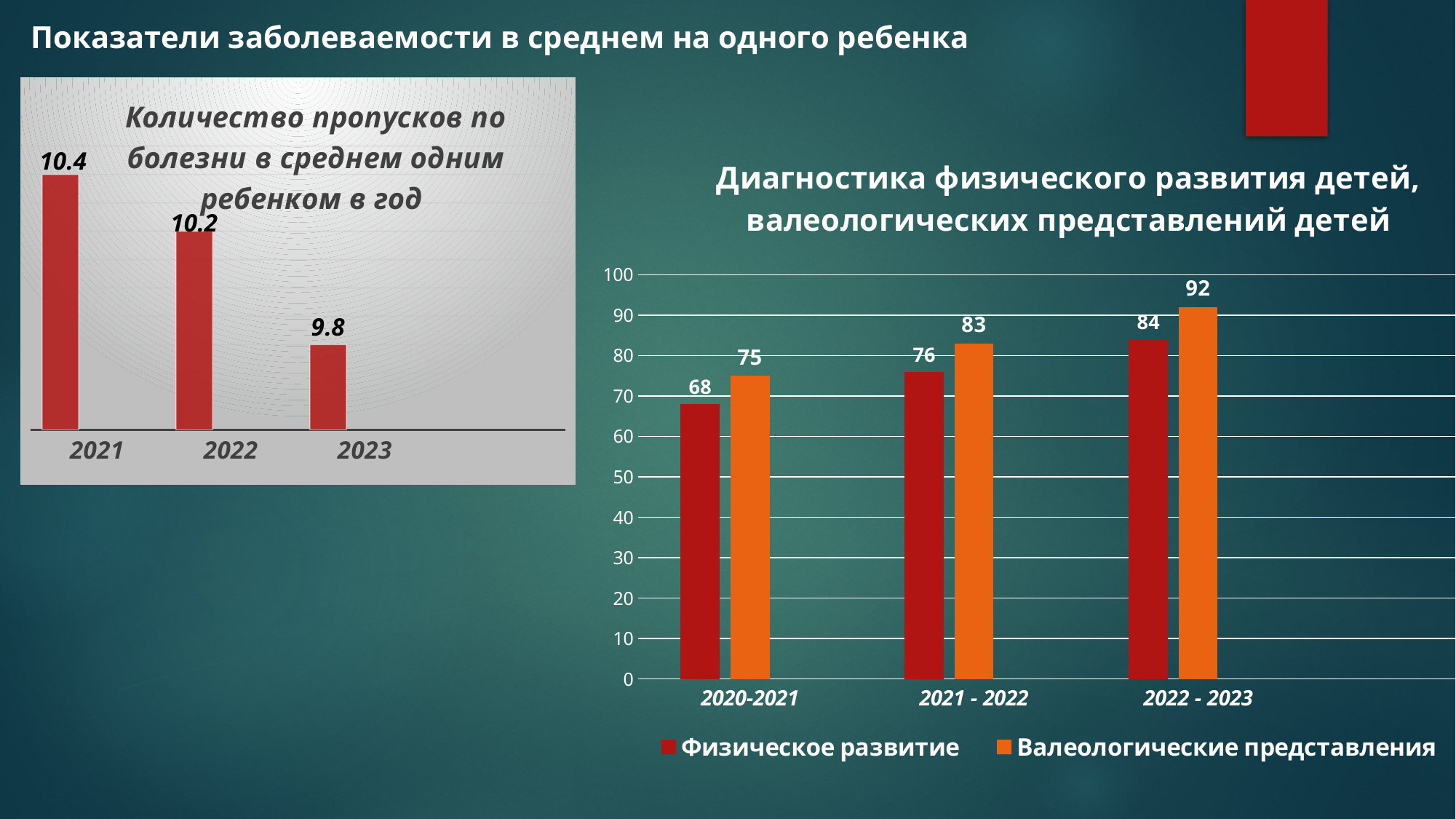
In the right chart 'Диагностика физического развития детей, валеологических представлений детей', what is the difference between Валеологические представления and Физическое развитие in 2022 - 2023? 8 In the left chart 'Количество пропусков по болезни в среднем одним ребенком в год', what is the difference between the 2021 and 2023 values? 0.6 In the right chart 'Диагностика физического развития детей, валеологических представлений детей', which is larger in 2021 - 2022: Физическое развитие or Валеологические представления? Валеологические представления In the right chart 'Диагностика физического развития детей, валеологических представлений детей', how many series does the legend list? 2 What kind of chart is the right chart 'Диагностика физического развития детей, валеологических представлений детей'? bar chart In the left chart 'Количество пропусков по болезни в среднем одним ребенком в год', do the values rise or fall from 2021 to 2023? fall In the left chart 'Количество пропусков по болезни в среднем одним ребенком в год', what is the value for 2021? 10.4 In the right chart 'Диагностика физического развития детей, валеологических представлений детей', what is the value for Валеологические представления in 2021 - 2022? 83 In the left chart 'Количество пропусков по болезни в среднем одним ребенком в год', which year has the lowest value? 2023 In the left chart 'Количество пропусков по болезни в среднем одним ребенком в год', how many years are shown? 3 In the right chart 'Диагностика физического развития детей, валеологических представлений детей', what is the value for Физическое развитие in 2020-2021? 68 In the right chart 'Диагностика физического развития детей, валеологических представлений детей', which period has the highest value for Валеологические представления? 2022 - 2023